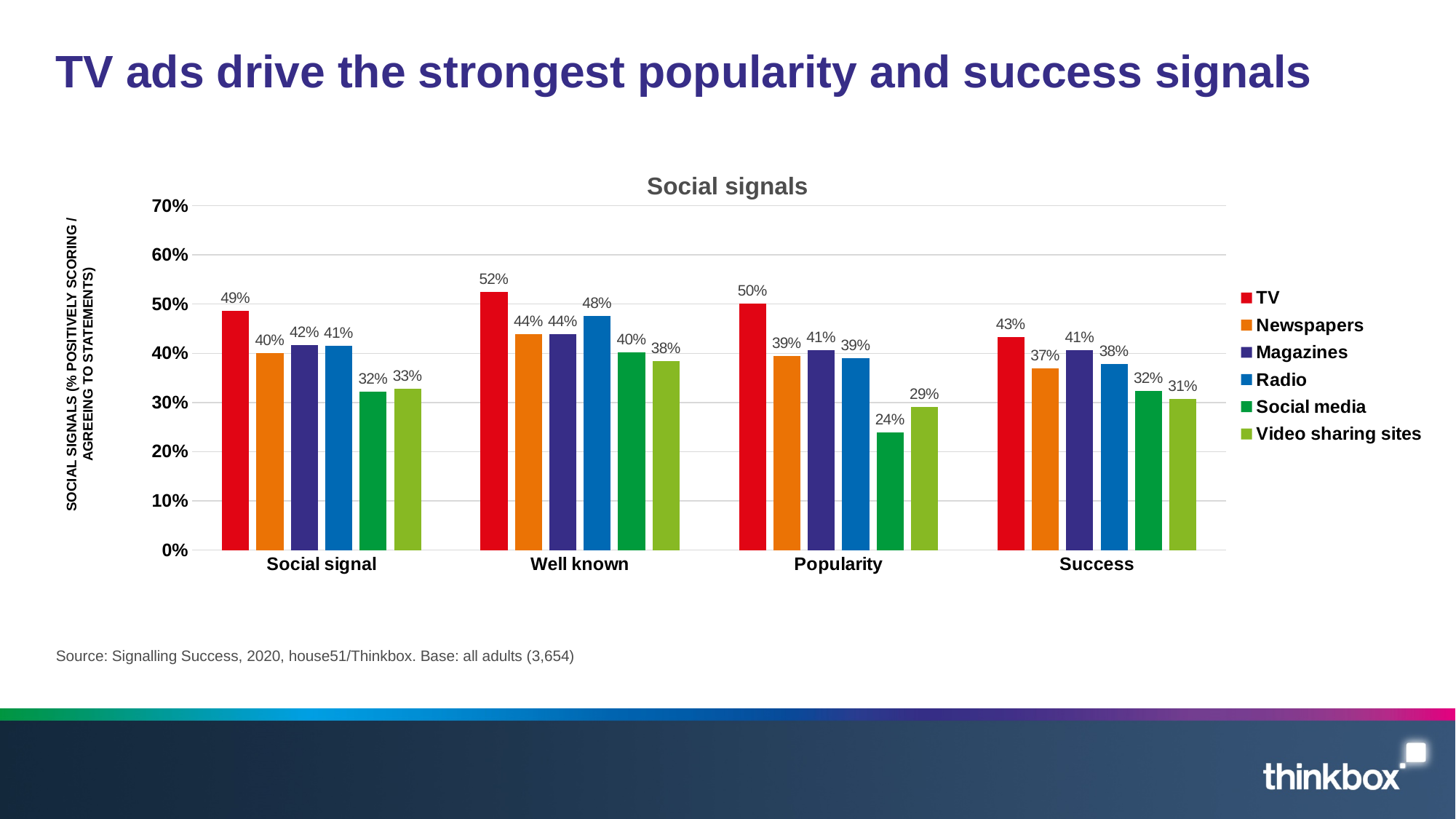
How many series does the legend list? 6 What is the title of the chart? Social signals How many categories are shown on the x axis? 4 What is the value for Social media in the Popularity category? 24% Which series has the highest value in the Popularity category? TV Which series has the lowest value in the Success category? Video sharing sites What is the difference between TV and Newspapers in the Social signal category? 9% What is the value for TV in the Well known category? 52% Which is larger in the Well known category: Radio or Social media? Radio What colour represents Newspapers in the chart? Orange What is the value for Radio in the Success category? 38% What kind of chart is shown on the slide? Bar chart